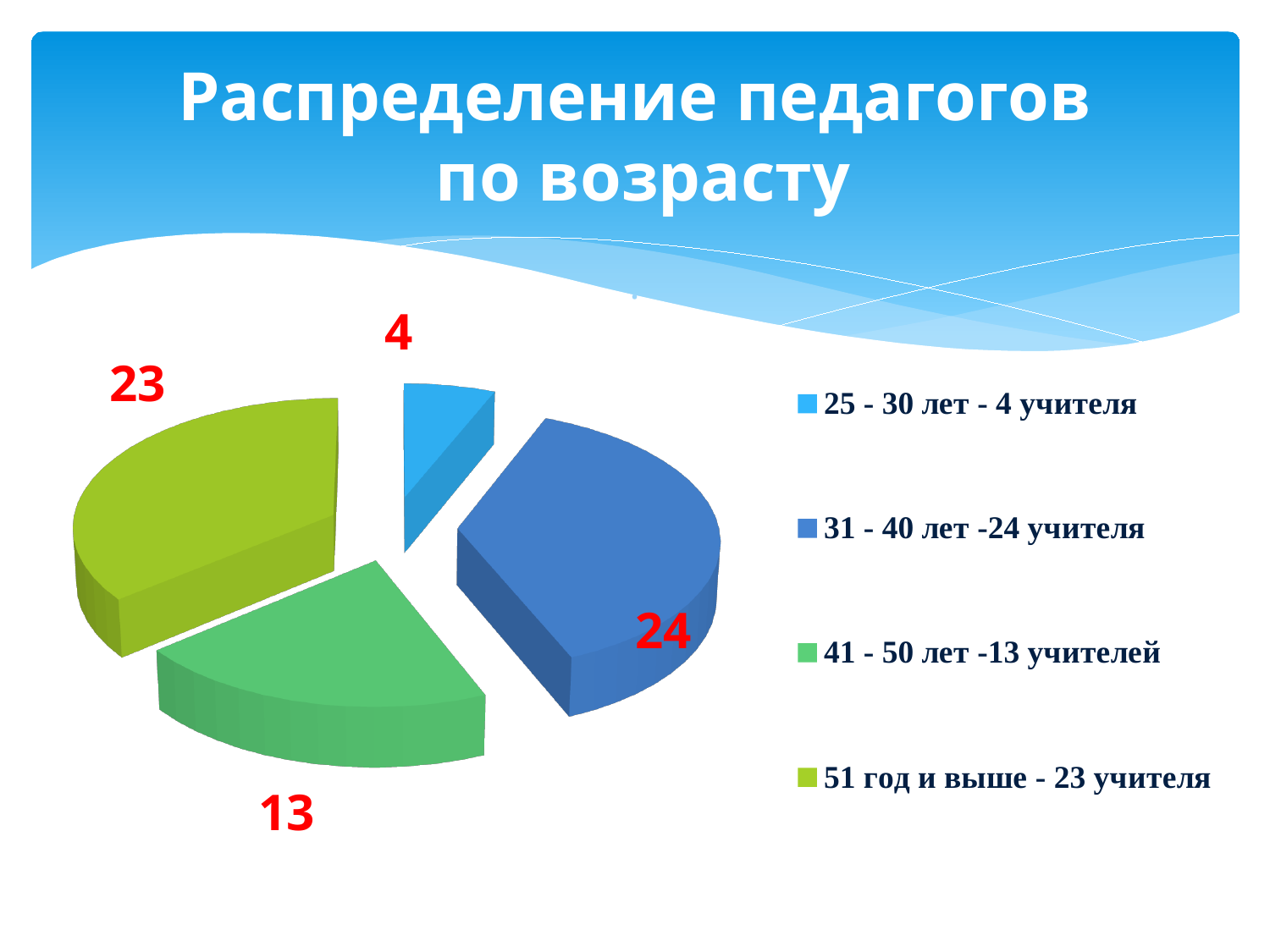
What is the difference between the 31 - 40 лет slice and the 41 - 50 лет slice? 11 How many slices does the pie chart have? 4 What is the value for the 41 - 50 лет slice? 13 Which age group has the largest number of teachers? 31 - 40 лет What is the value for the 31 - 40 лет slice? 24 Which is larger, the 51 год и выше slice or the 41 - 50 лет slice? 51 год и выше What kind of chart is shown on the slide? pie chart What is the value for the 51 год и выше slice? 23 What is the title of the chart on the slide? Распределение педагогов по возрасту Which age group has the smallest number of teachers? 25 - 30 лет What is the value for the 25 - 30 лет slice? 4 What share of the pie does the 31 - 40 лет slice represent? 37.5%